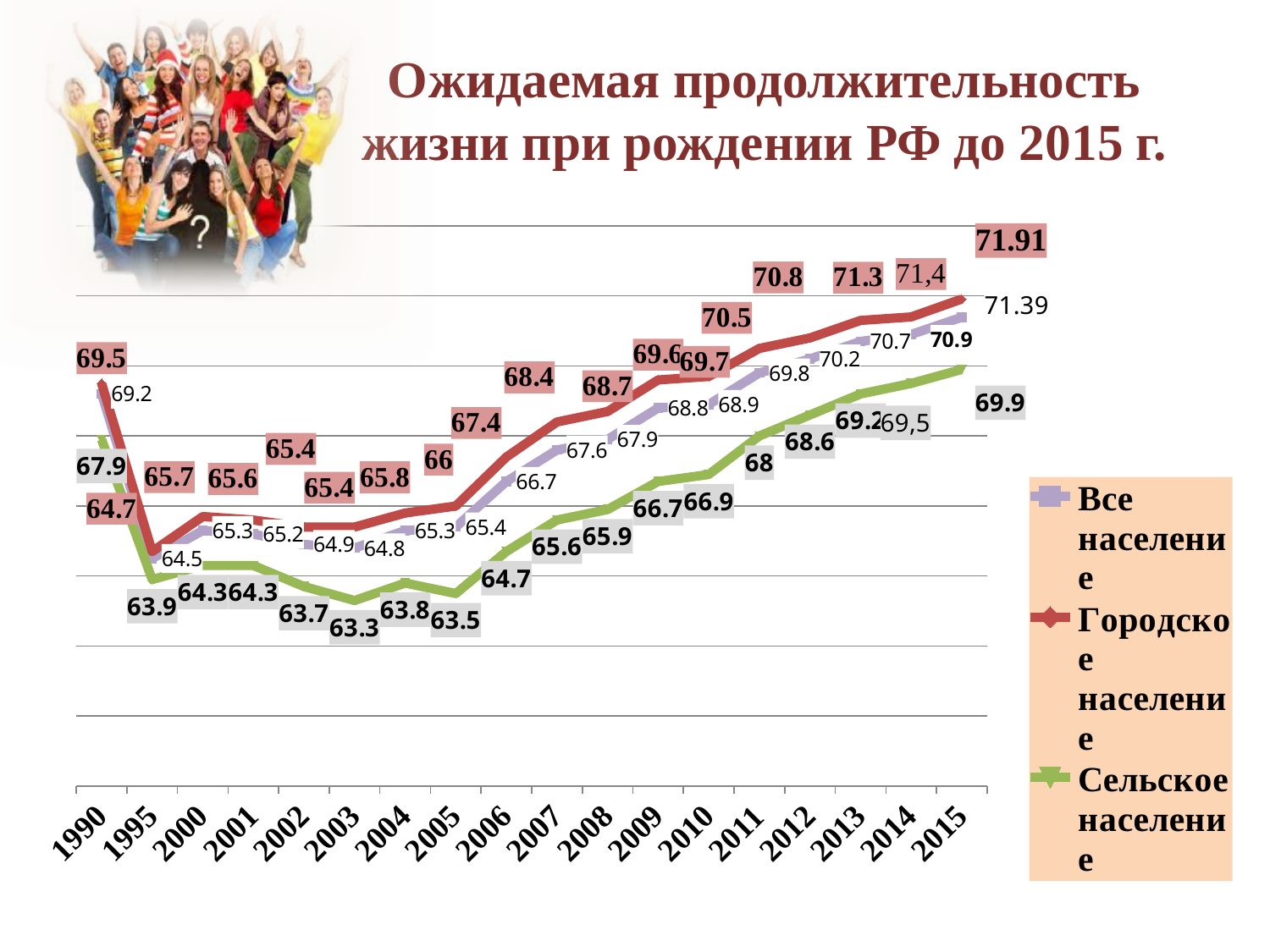
How many years are shown along the x axis? 18 What is the value for Все население in 2015? 71.39 What kind of chart is shown on the slide? line chart How many series does the legend list? 3 Do the values for Все население rise or fall from 2005 to 2015? rise What is the value for Сельское население in 2015? 69.9 In 1990, which is higher: Городское население or Сельское население? Городское население What is the difference between Городское население and Сельское население in 2015? 2.01 What is the value for Городское население in 2015? 71.91 In which year is the Сельское население series at its lowest? 2003 What is the value for Сельское население in 1995? 63.9 In which year is the Городское население series at its highest? 2015